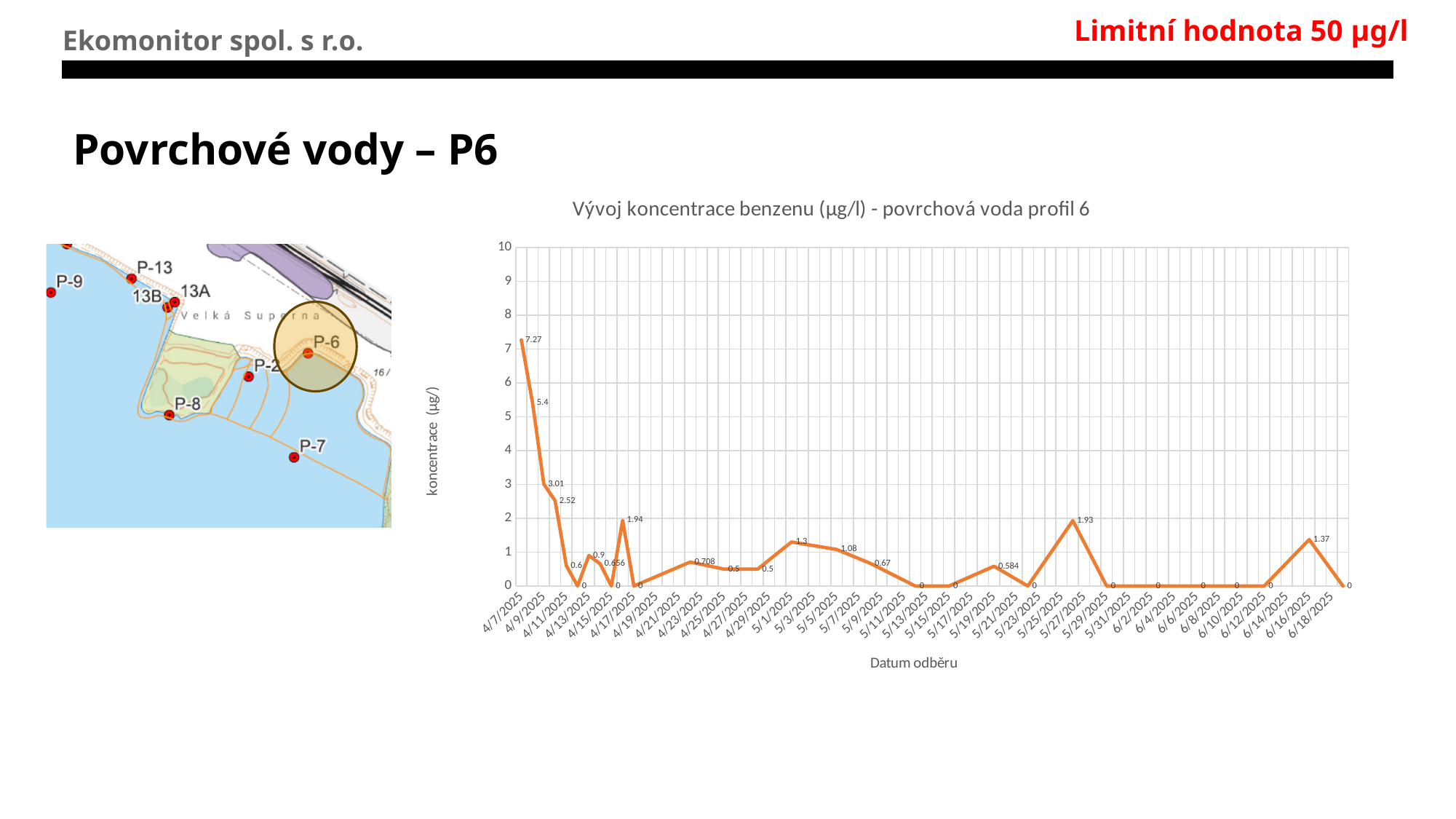
What is the highest value shown on the chart? 7.27 Overall, do the values rise or fall from the start of the period to the end? fall What is the label of the x axis of the chart? Datum odběru On which date does the chart reach its highest value? 4/7/2025 What kind of chart is shown on the slide? line chart Which is larger: the late-May peak of 1.93 or the mid-June peak of 1.37? 1.93 What is the difference between the first value (7.27) and the second value (5.4)? 1.87 Is the value for 4/7/2025 greater or less than 5? greater What is the title of the chart? Vývoj koncentrace benzenu (µg/l) - povrchová voda profil 6 What is the benzene concentration value plotted for 4/7/2025? 7.27 What is the value plotted for the last date, 6/18/2025? 0 How many data series are plotted on the chart? 1